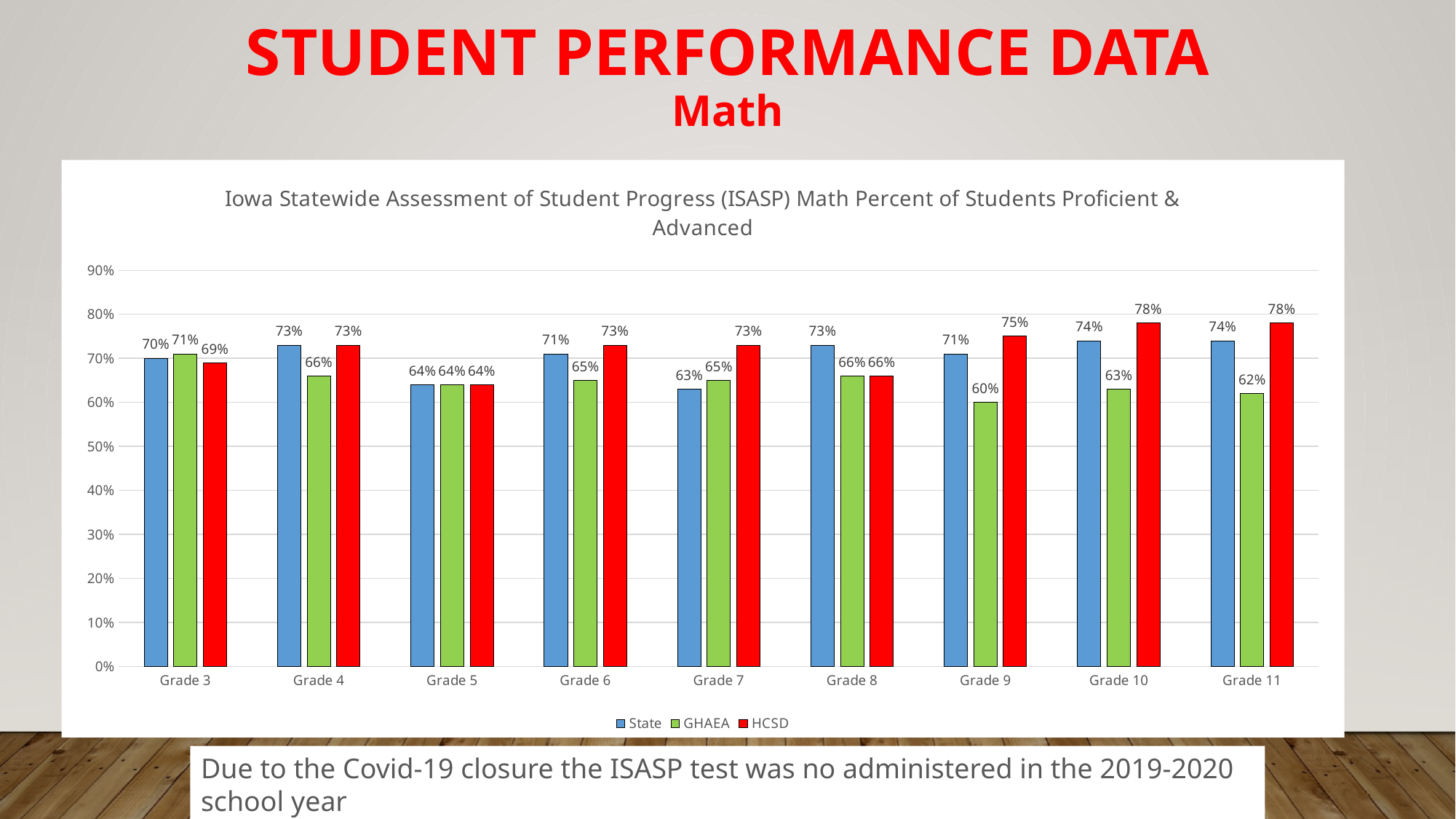
What is the HCSD value for Grade 9? 75% Which grade has the lowest GHAEA value? Grade 9 What is the difference between the HCSD and GHAEA values for Grade 11? 16% How many grade categories are shown on the x axis? 9 What is the State value for Grade 7? 63% What is the GHAEA value for Grade 4? 66% What is the difference between the HCSD and State values for Grade 7? 10% Which is larger for Grade 3, the State value or the HCSD value? State Which is larger for Grade 10, the GHAEA value or the HCSD value? HCSD What kind of chart is shown on the slide? Bar chart Which grade has the lowest State value? Grade 7 How many series does the legend list? 3